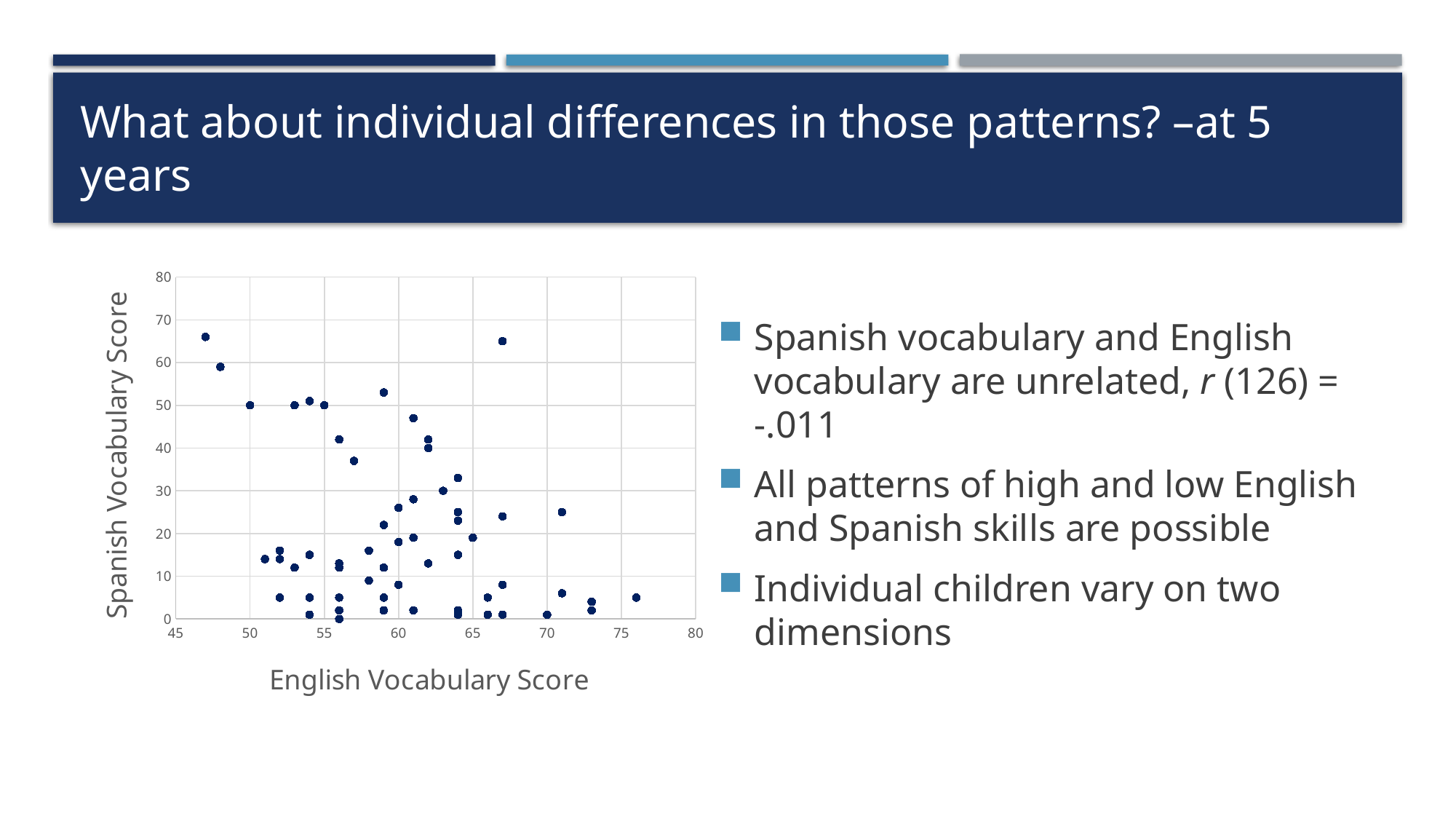
What is the title of the vertical axis of the chart? Spanish Vocabulary Score What is the title of the horizontal axis of the chart? English Vocabulary Score Are any points in the chart plotted above 70 on the Spanish Vocabulary Score axis? no What kind of chart is shown on the slide? scatter plot Is the Spanish Vocabulary Score of the rightmost point in the chart greater or less than 10? less How many data series are plotted in the chart? 1 Are any points in the chart plotted beyond 75 on the English Vocabulary Score axis? yes Does the chart show a clear rising or falling trend in Spanish Vocabulary Score as English Vocabulary Score increases? no clear trend